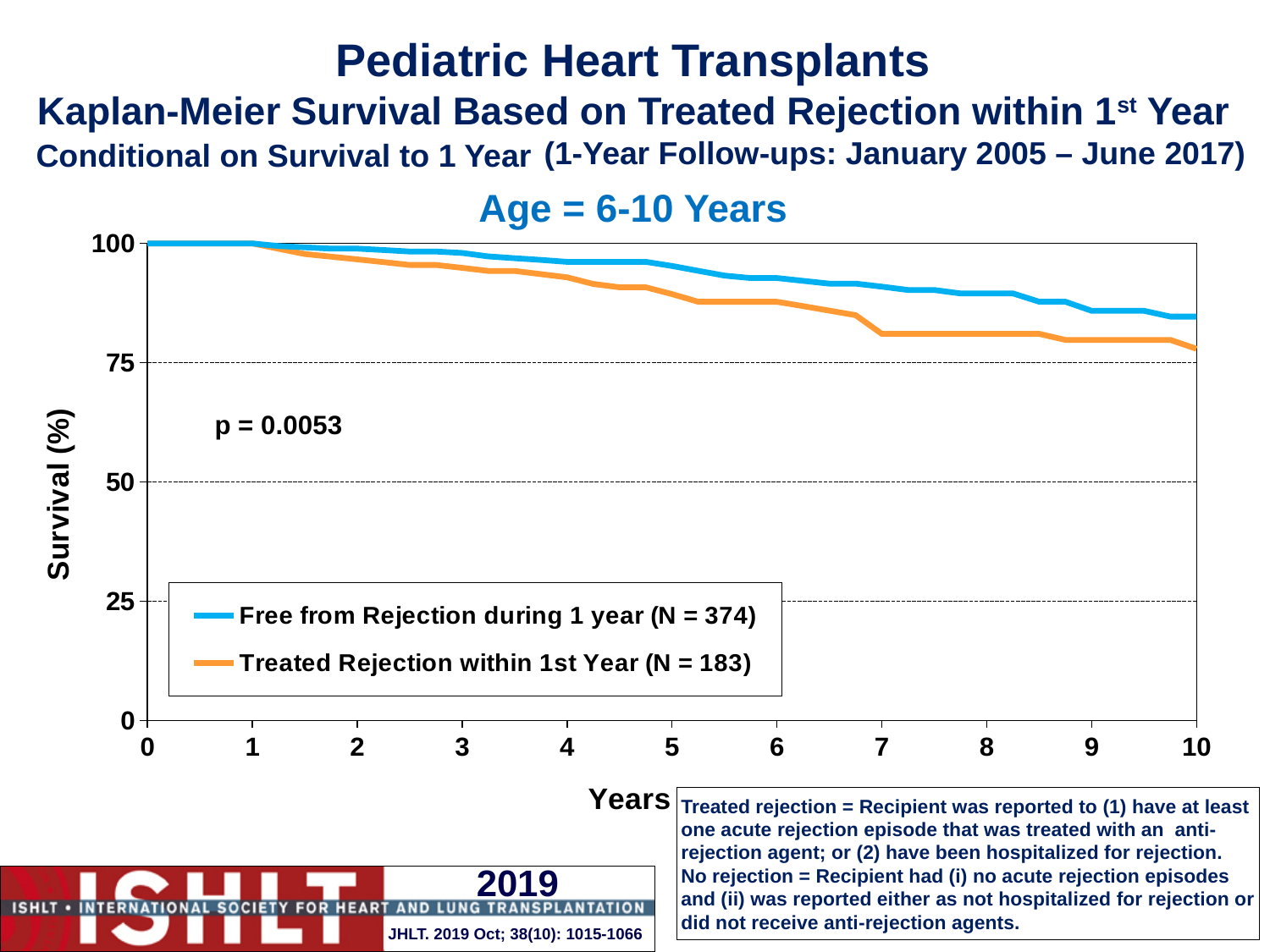
Does the survival for the Treated Rejection within 1st Year group rise or fall over the 10 years? Fall What is the p-value shown on the chart? p = 0.0053 What kind of chart is shown on the slide? Line chart Is the survival for the Treated Rejection within 1st Year group at year 5 greater or less than 75? greater At year 7, which group has higher survival: Free from Rejection during 1 year or Treated Rejection within 1st Year? Free from Rejection during 1 year Is the survival for the Treated Rejection within 1st Year group at year 8 greater or less than 100? less At year 10, which group has lower survival: Free from Rejection during 1 year or Treated Rejection within 1st Year? Treated Rejection within 1st Year Does the survival for the Free from Rejection during 1 year group rise or fall as years increase? Fall Is the survival for the Free from Rejection during 1 year group at year 10 greater or less than 75? greater How many series does the legend list? 2 What is the N for the Free from Rejection during 1 year group in the legend? 374